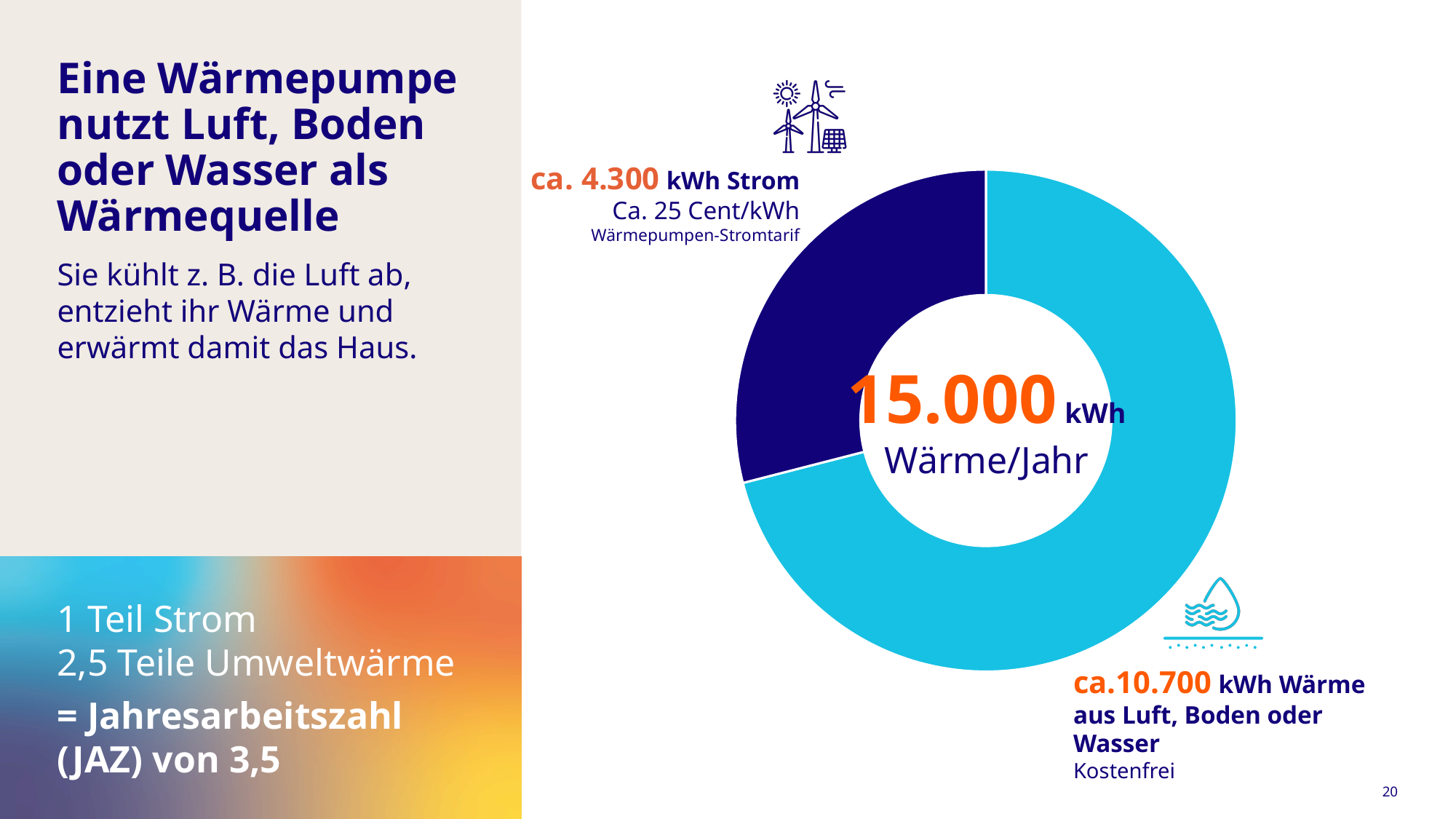
Which segment of the chart is the smallest? Strom What colour is the Strom segment of the donut chart? dark blue Which is larger, the Strom segment or the Wärme aus Luft, Boden oder Wasser segment? Wärme aus Luft, Boden oder Wasser What electricity price per kWh is given next to the Strom segment? Ca. 25 Cent/kWh Is the value for the Strom segment greater or less than 5.000 kWh? less What value is printed for the Strom segment of the chart? ca. 4.300 kWh What value is printed for the Wärme aus Luft, Boden oder Wasser segment? ca. 10.700 kWh What total is shown in the centre of the donut chart? 15.000 kWh Wärme/Jahr What is the difference in kWh between the Wärme aus Luft, Boden oder Wasser segment and the Strom segment? 6.400 kWh Which segment of the chart is the largest? Wärme aus Luft, Boden oder Wasser What kind of chart is shown on the slide? pie chart (donut) How many segments does the donut chart have? 2